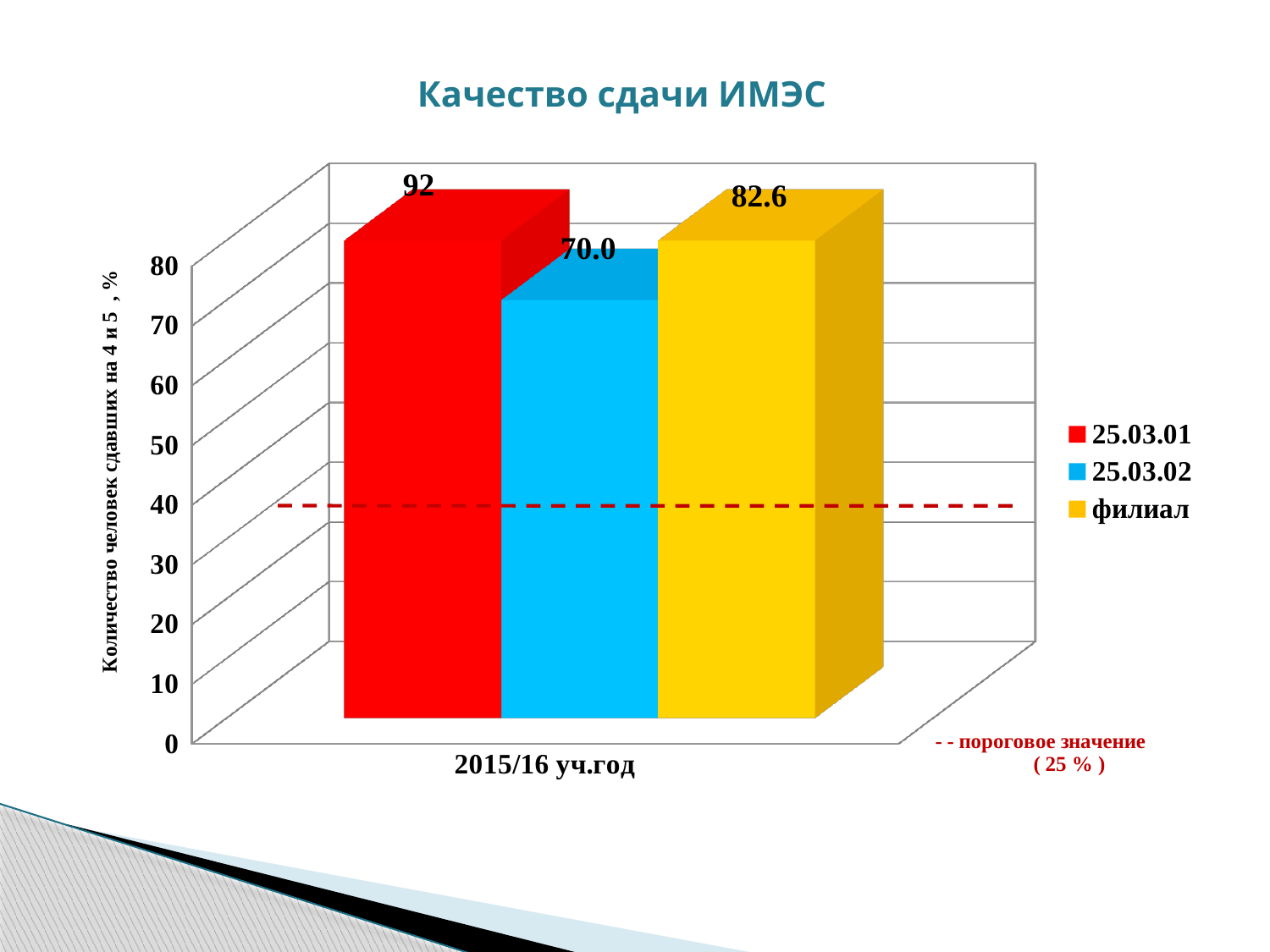
What is the value for 25.03.02 in 2015/16 уч.год? 70.0 What is the difference between the values for филиал and 25.03.02? 12.6 What is the value for 25.03.01 in 2015/16 уч.год? 92 How many series does the legend list? 3 Which series has the lowest value? 25.03.02 What is the title of the chart? Качество сдачи ИМЭС Which series has the highest value? 25.03.01 Which is larger, the value for филиал or the value for 25.03.02? филиал What threshold value (пороговое значение) is indicated by the dashed line? 25 % What is the value for филиал in 2015/16 уч.год? 82.6 What is the difference between the values for 25.03.01 and 25.03.02? 22 What kind of chart is shown on the slide? bar chart